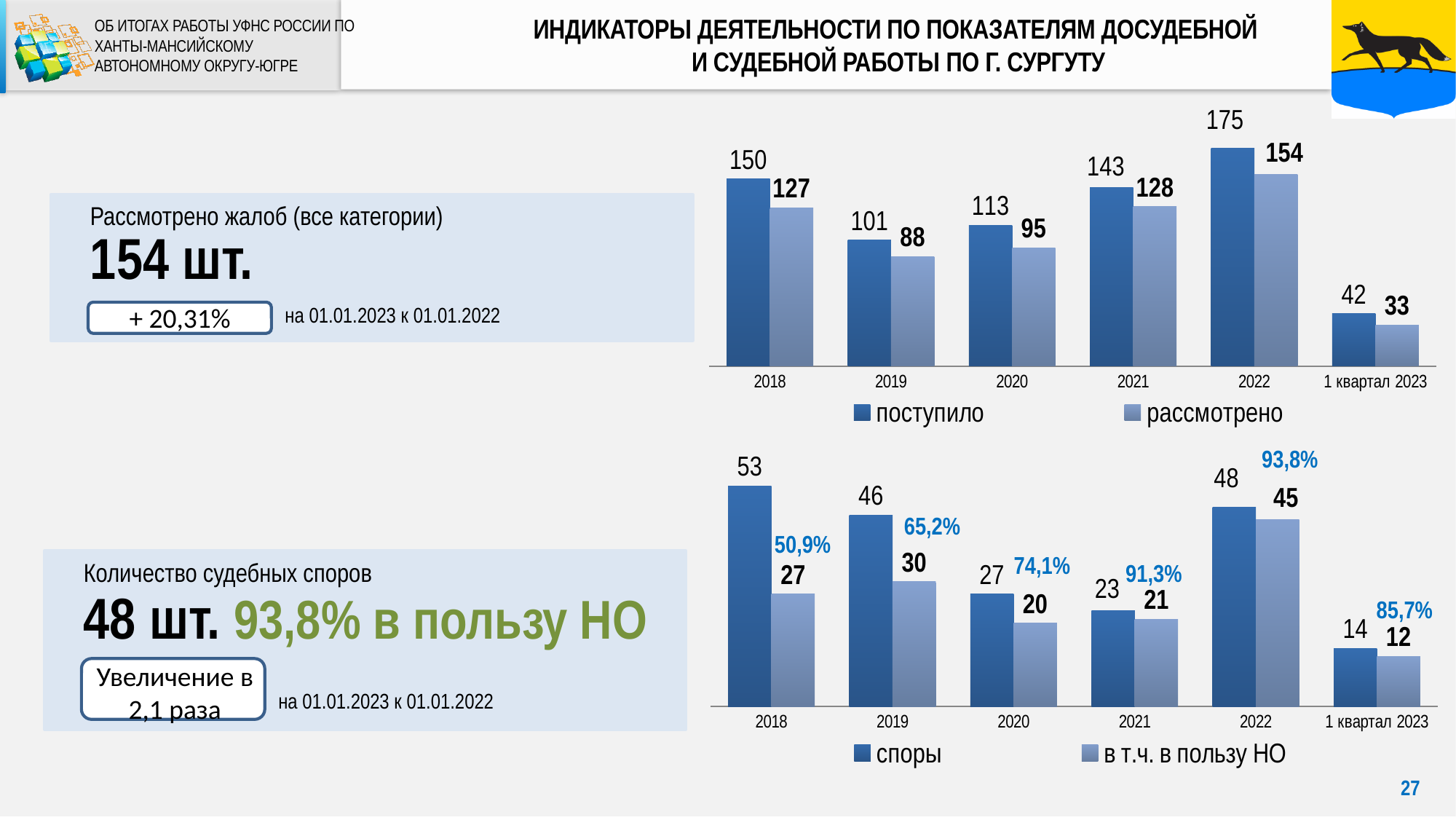
In the top chart, what is the difference between "поступило" and "рассмотрено" in 2021? 15 In the top chart, which category has the lowest value for "рассмотрено"? 1 квартал 2023 In the bottom chart, what is the value of "споры" for 2019? 46 In the top chart, what is the value of "поступило" for 2022? 175 In the top chart, what is the value of "рассмотрено" for 2019? 88 In the bottom chart, what percentage is shown above the 2020 bars? 74,1% In the bottom chart, what is the value of "в т.ч. в пользу НО" for 2022? 45 In the bottom chart, which year has the highest value for "споры"? 2018 In the top chart, which year has the highest value for "поступило"? 2022 In the bottom chart, is the value of "споры" larger in 2020 or in 2021? 2020 In the top chart, how many series does the legend list? 2 What type of chart is the bottom chart? bar chart